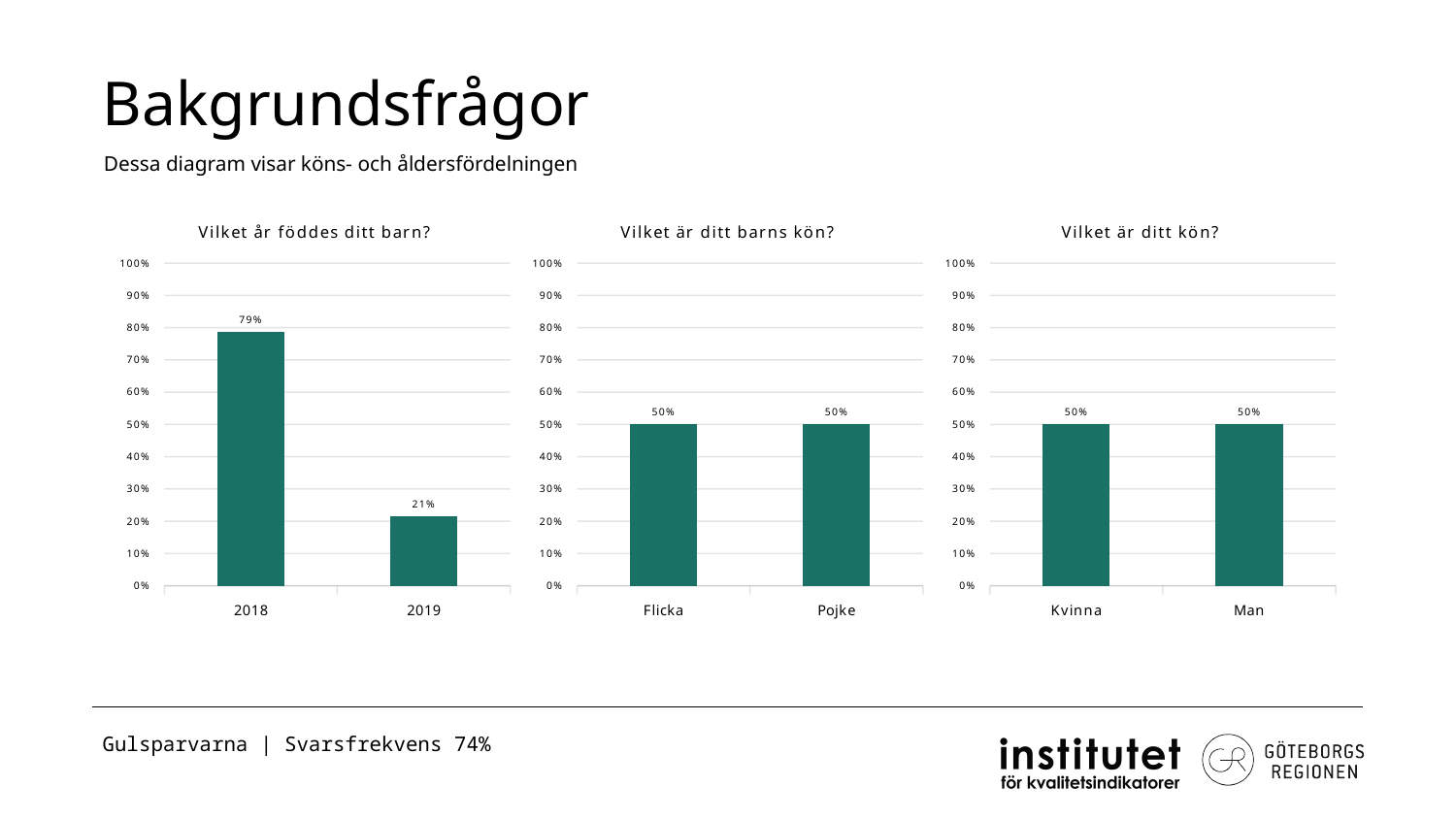
In the chart titled "Vilket år föddes ditt barn?", what is the value for 2019? 21% In the chart titled "Vilket år föddes ditt barn?", what is the difference between the values for 2018 and 2019? 58% In the chart titled "Vilket år föddes ditt barn?", what is the value for 2018? 79% In the chart titled "Vilket är ditt kön?", what is the value for Kvinna? 50% What kind of chart is the chart titled "Vilket är ditt kön?"? bar chart In the chart titled "Vilket år föddes ditt barn?", which category has the lowest value? 2019 In the chart titled "Vilket år föddes ditt barn?", is the value for 2019 greater or less than 30%? less In the chart titled "Vilket är ditt barns kön?", what is the value for Flicka? 50% In the chart titled "Vilket är ditt kön?", how many categories are shown on the x axis? 2 How many charts are shown on the slide? 3 In the chart titled "Vilket är ditt barns kön?", what is the value for Pojke? 50% In the chart titled "Vilket år föddes ditt barn?", which category has the highest value? 2018